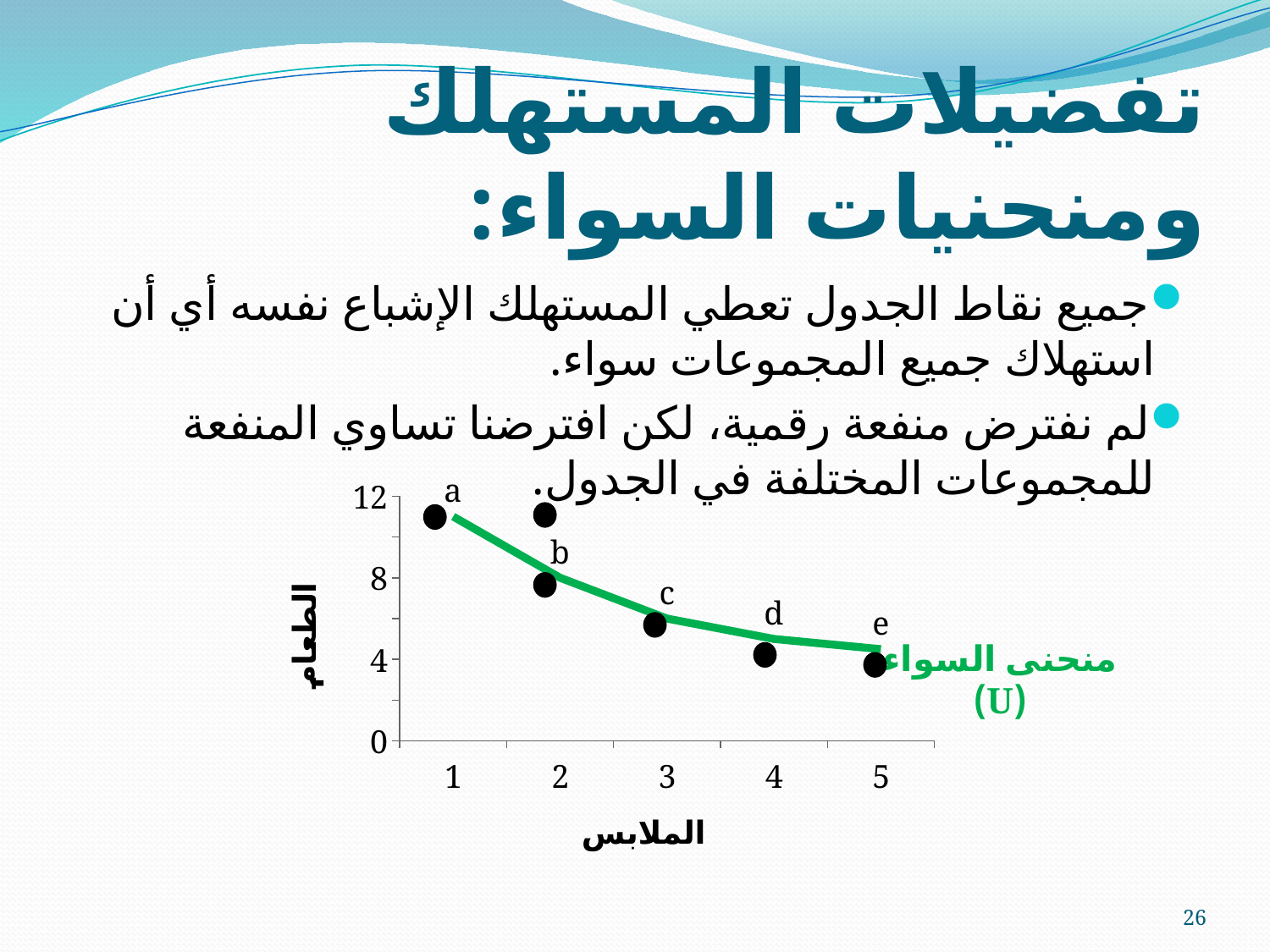
Is the value for point c greater or less than 4? greater Which is larger, the value for point b or the value for point e? b Do the values of the labeled points rise or fall as you move along the x axis from 1 to 5? fall Is the value for point c greater or less than 8? less What kind of chart is shown on the slide? line chart How many labeled points (a through e) are plotted on the chart? 5 Is the value for point b greater or less than 4? greater What is the title of the x axis? الملابس Which is larger, the value for point a or the value for point c? a What label is given to the green curve on the chart? منحنى السواء (U) Which labeled point has the highest value on the الطعام axis? a